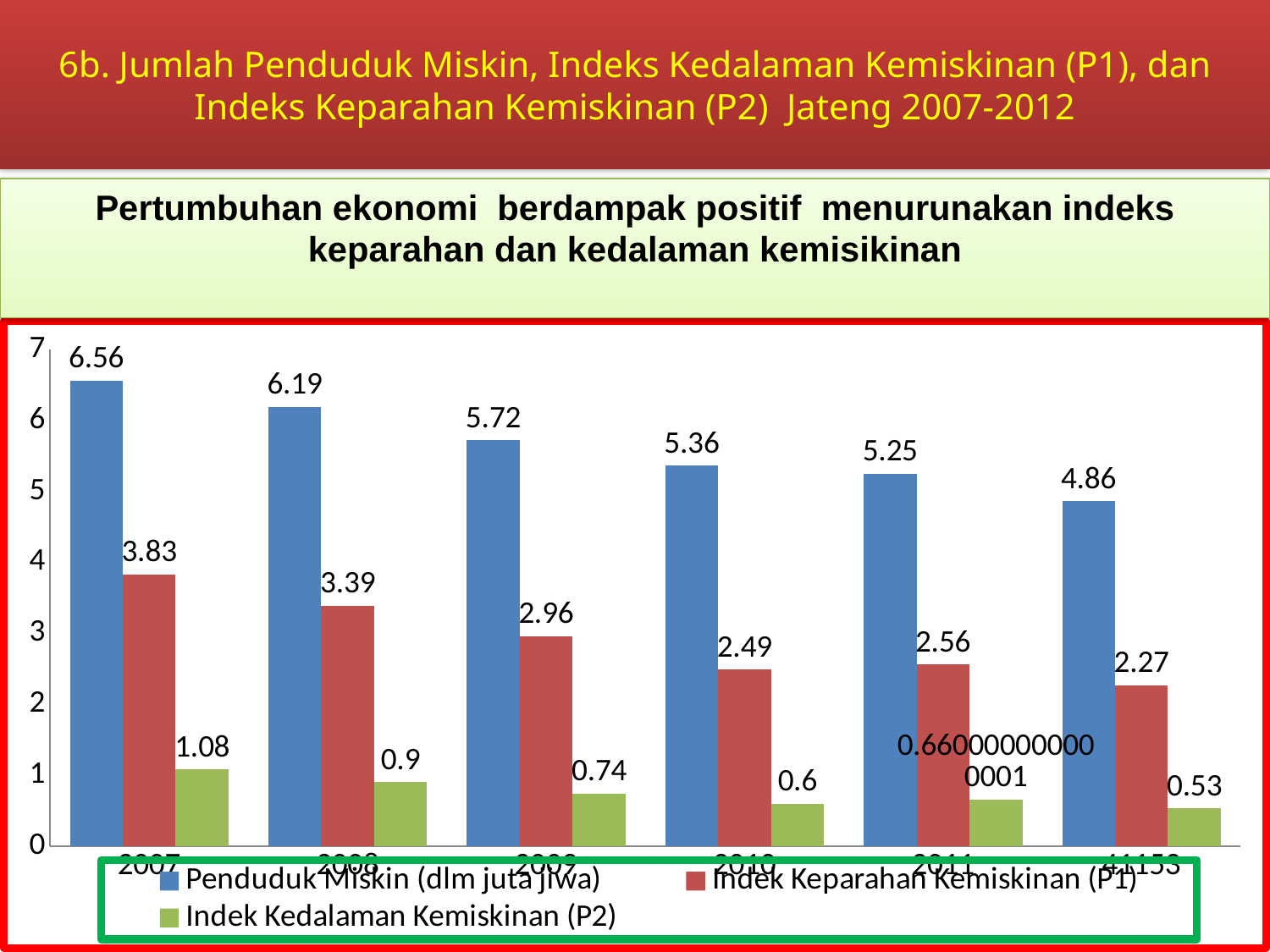
What is the value of Indek Kedalaman Kemiskinan (P2) for 2008? 0.9 In which year is Penduduk Miskin (dlm juta jiwa) highest? 2007 What is the value of Penduduk Miskin (dlm juta jiwa) for 2007? 6.56 How many year categories are shown on the x axis? 6 How many series does the legend list? 3 Among 2007 to 2011, in which year is Indek Keparahan Kemiskinan (P1) lowest? 2010 Is the value of Indek Kedalaman Kemiskinan (P2) for 2007 greater or less than 1? greater Which is larger, Indek Keparahan Kemiskinan (P1) in 2010 or in 2011? 2011 What is the value of Indek Keparahan Kemiskinan (P1) for 2009? 2.96 What kind of chart is shown on the slide? bar chart Does Penduduk Miskin (dlm juta jiwa) rise or fall from 2007 to 2011? fall What is the difference between Penduduk Miskin (dlm juta jiwa) in 2007 and in 2008? 0.37